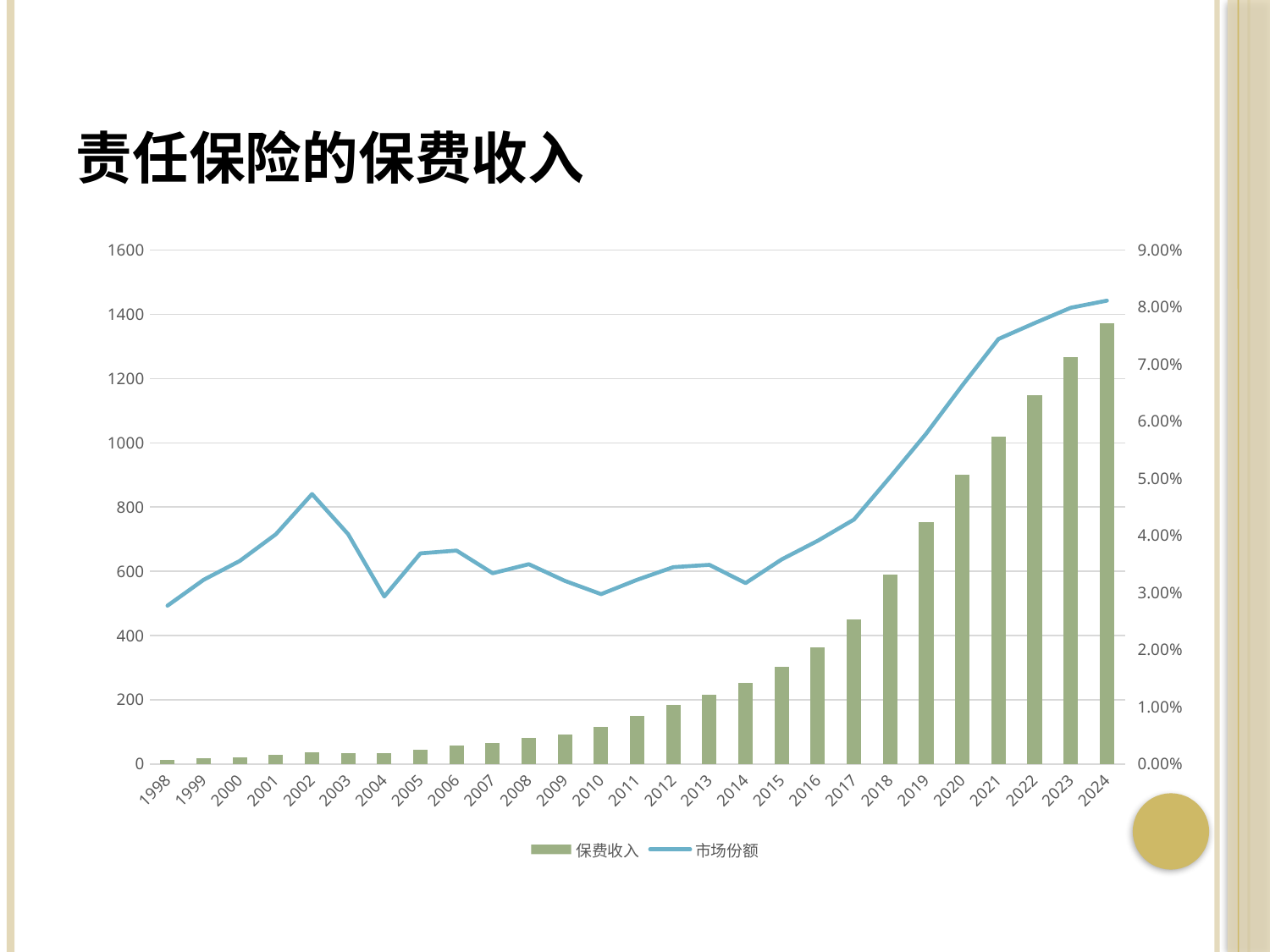
How many years are shown on the x axis of the chart? 27 Which year has the larger 市场份额 value, 2002 or 2010? 2002 Do the 保费收入 bars generally rise or fall from 1998 to 2024? Rise Is the 市场份额 value for 2002 greater or less than 4.00%? greater Is the 保费收入 value for 2016 greater or less than 400? less How many series does the legend list? 2 What kind of chart is shown on the slide? A combined bar and line chart What is the title of the slide above the chart? 责任保险的保费收入 Which year has the lowest 保费收入 bar? 1998 Which year has the highest 保费收入 bar? 2024 What are the two series named in the legend? 保费收入 and 市场份额 Is the 保费收入 value for 2024 greater or less than 1200? greater